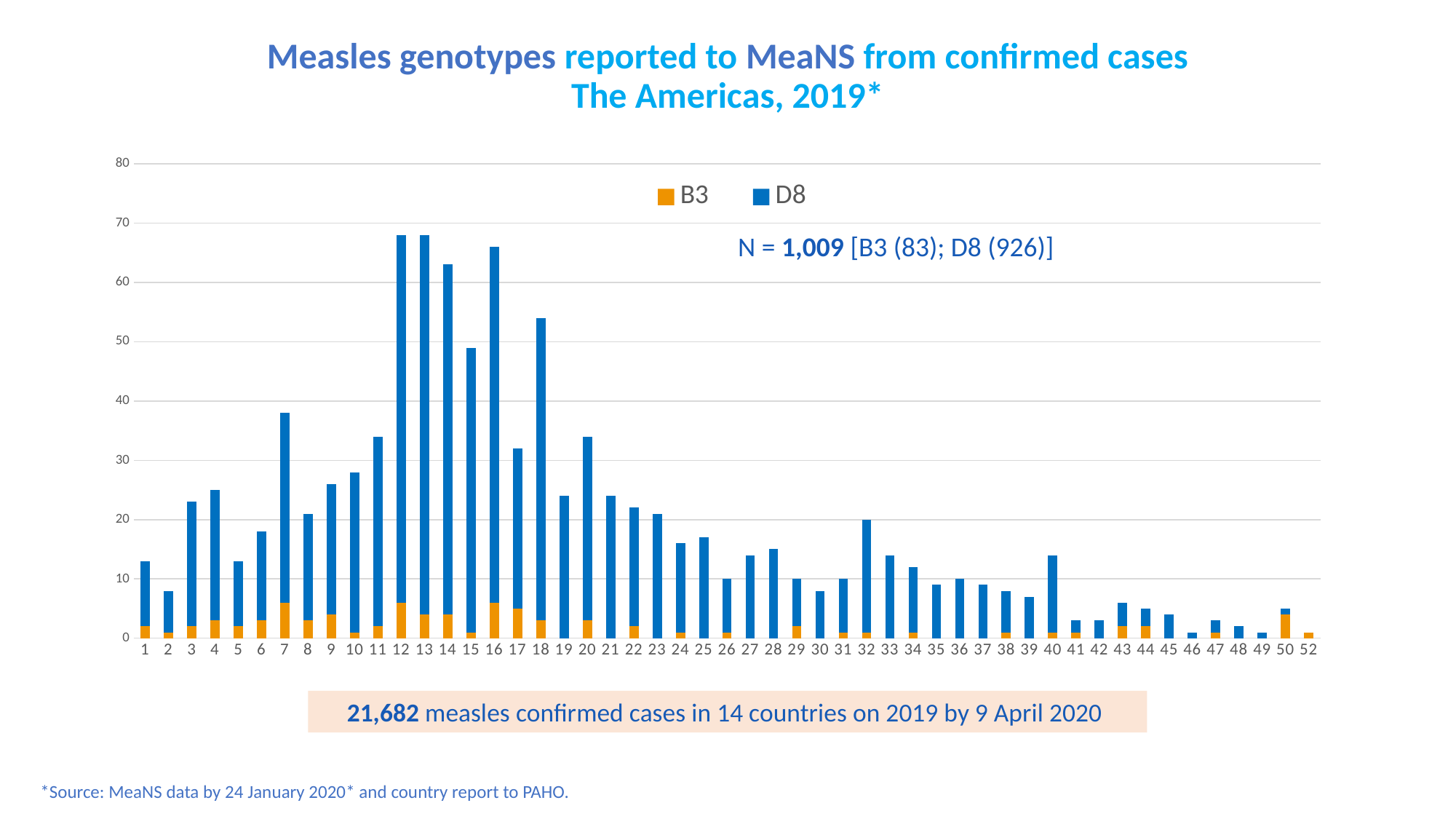
What kind of chart is shown on the slide? Stacked bar chart What total N is stated on the chart? 1,009 Is the total value for week 7 greater or less than 30? greater Is the total value for week 12 greater or less than 60? greater Which week has the larger total, week 16 or week 17? Week 16 Do the weekly totals generally rise or fall from week 18 to week 30? Fall Which week has the larger total, week 7 or week 8? Week 7 Is the total value for week 18 greater or less than 50? greater Which two genotypes are listed in the legend? B3 and D8 How many series does the legend list? 2